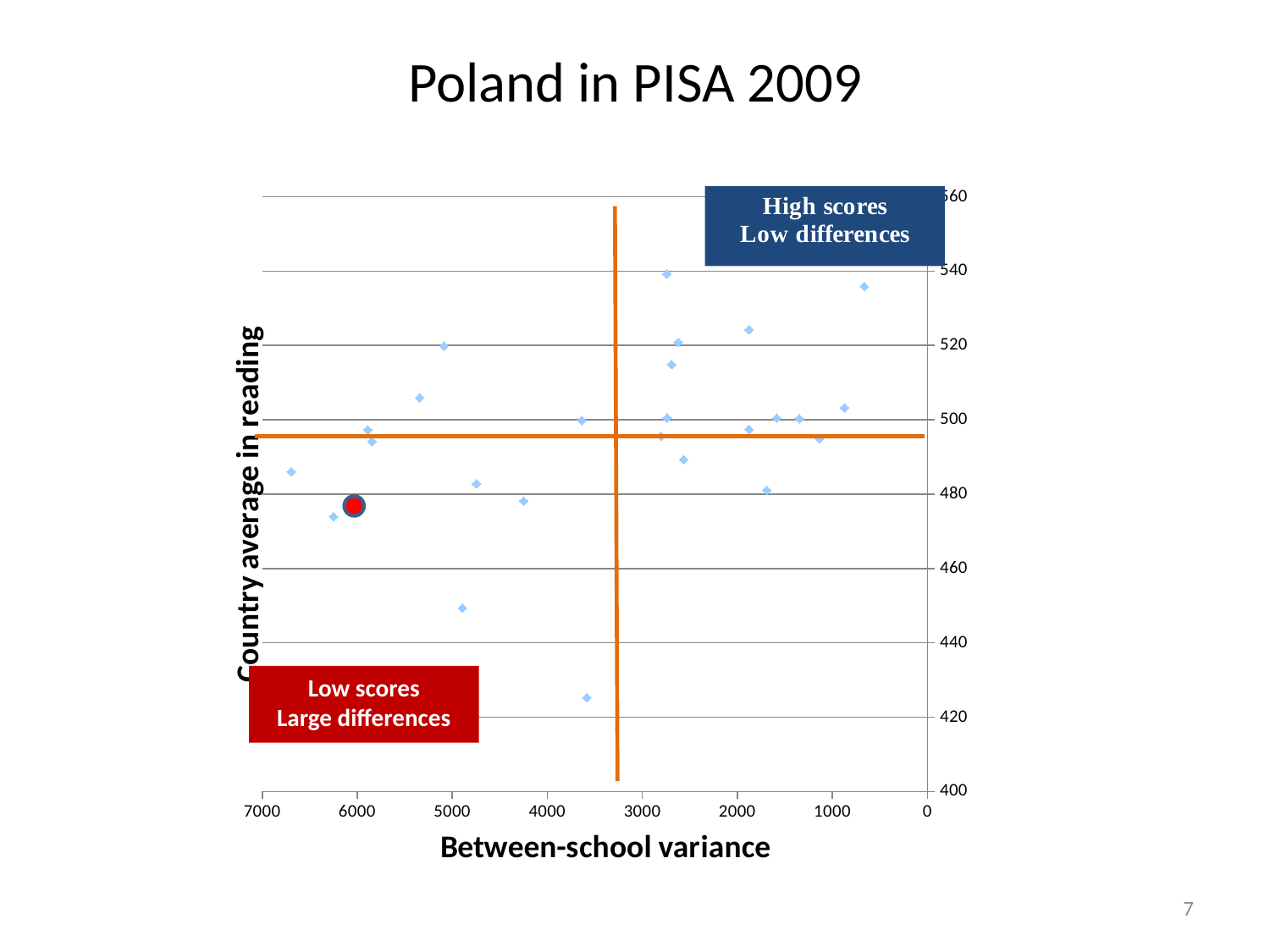
Is the country average in reading for Poland (the red point) greater or less than 500? less Is the horizontal orange reference line drawn at a reading score greater or less than 500? less Is the country average in reading of the highest point on the chart greater or less than 520? greater What is the label of the horizontal axis? Between-school variance What is the title of the chart on the slide? Poland in PISA 2009 What kind of chart is shown on the slide? scatter chart